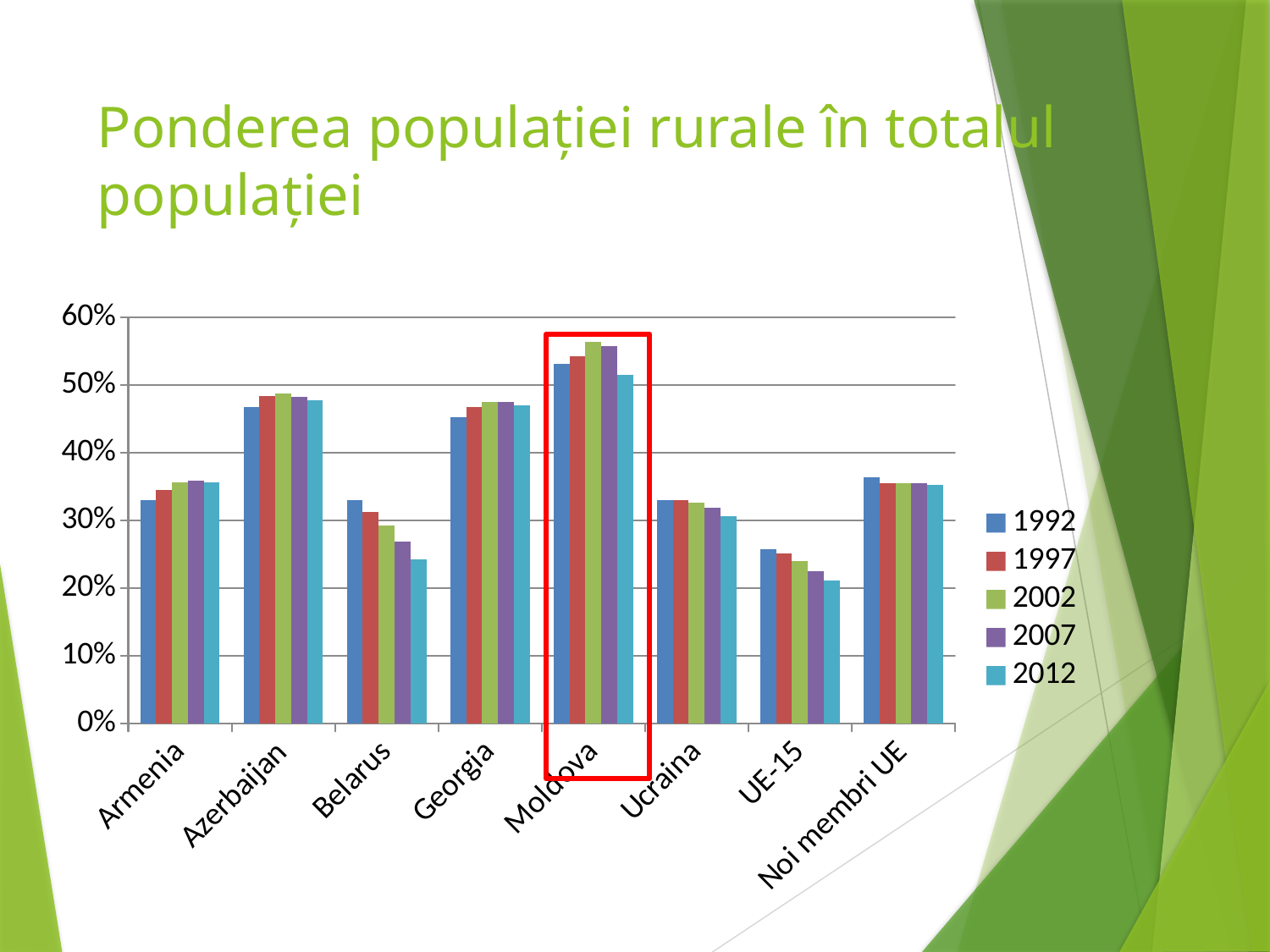
Is the value for Moldova in 2002 greater or less than 50%? greater How many series does the legend list? 5 Is the value for UE-15 in 1992 greater or less than 30%? less Is the value for Belarus in 2012 greater or less than 30%? less Which category is highlighted with a red box on the chart? Moldova Do the values for UE-15 rise or fall from 1992 to 2012? fall How many categories are shown on the x axis? 8 Which is larger, the 1992 value for Azerbaijan or the 1992 value for Armenia? Azerbaijan Do the values for Belarus rise or fall from 1992 to 2012? fall Which category has the lowest value for 2012? UE-15 Which category has the highest value for 2002? Moldova What kind of chart is shown on the slide? bar chart